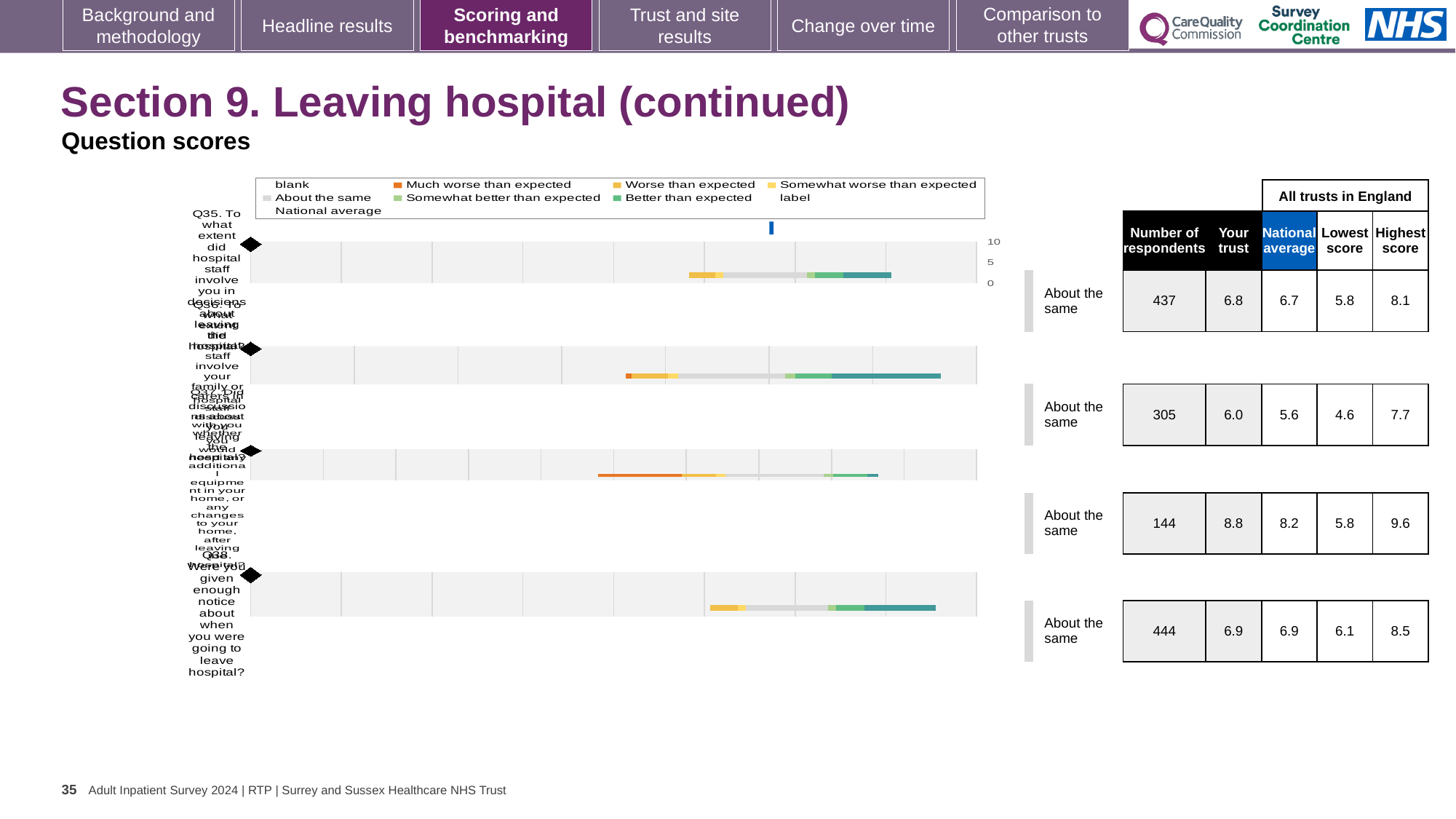
What is the national average score for Q38? 6.9 What benchmark category is shown for all four questions on the slide? About the same Which question row has the highest 'Your trust' score? Q37 (8.8) What is the highest score among all trusts in England for the third question row (Q37)? 9.6 Which question row has the lowest number of respondents? Q37 (144) What is the number of respondents for Q35 (To what extent did hospital staff involve you in decisions about leaving hospital?)? 437 What is the difference between the 'Your trust' score and the national average for the third question row (Q37)? 0.6 What is the 'Your trust' score for Q38 (Were you given enough notice about when you were going to leave hospital?)? 6.9 What is the lowest score among all trusts in England for the second question row (Q36)? 4.6 What kind of chart is shown on the slide? bar chart How many survey questions (rows) are plotted in the chart? 4 For Q35, which is larger: the 'Your trust' score or the national average? Your trust (6.8)